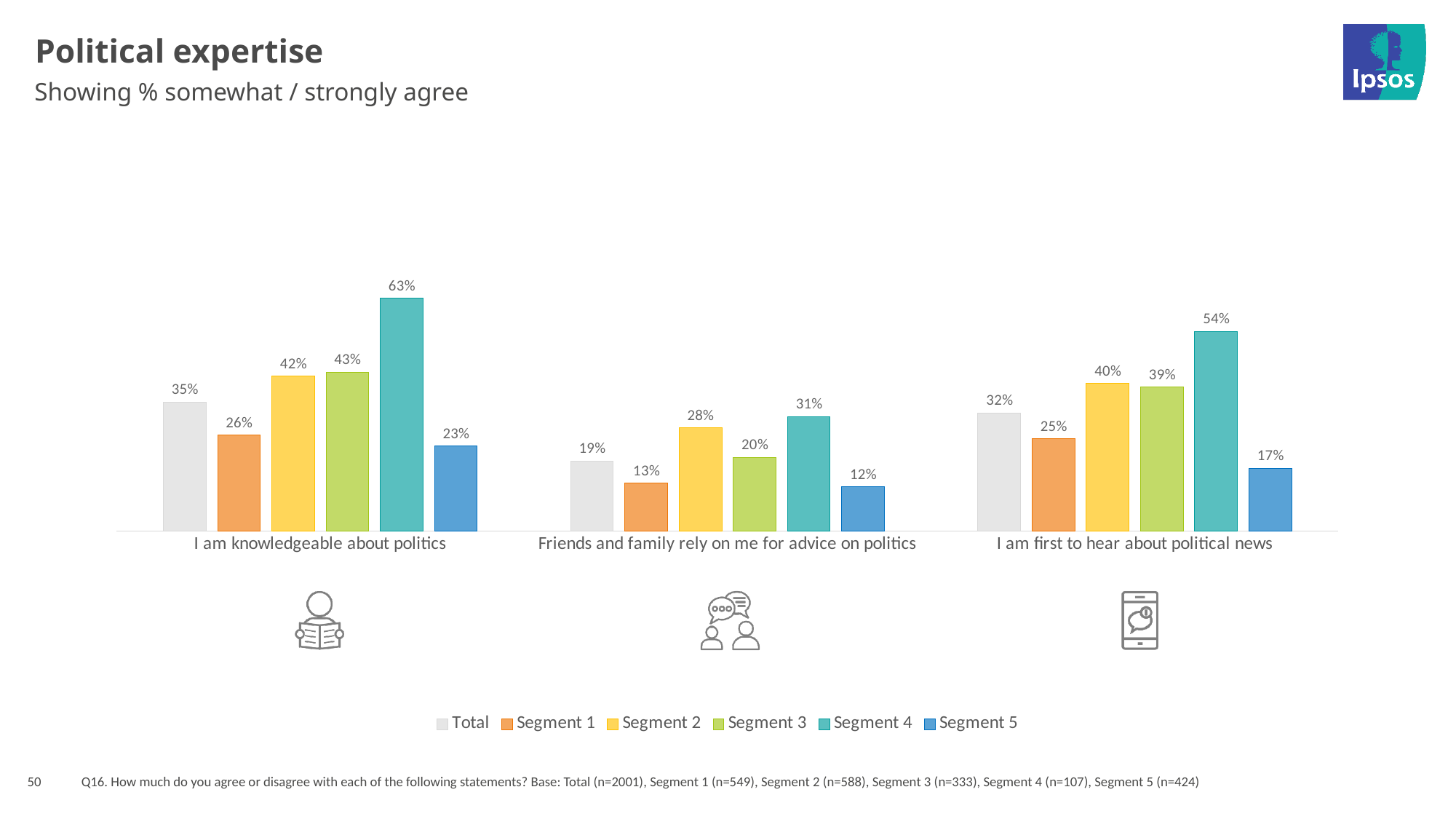
What is the title of the slide? Political expertise Which is larger for 'I am first to hear about political news': Segment 2 or Segment 3? Segment 2 What is the value for Segment 4 on 'I am knowledgeable about politics'? 63% What kind of chart is shown on the slide? Bar chart How many series does the legend list? 6 Which segment has the highest value for 'I am first to hear about political news'? Segment 4 Which segment has the lowest value for 'Friends and family rely on me for advice on politics'? Segment 5 What is the difference between Segment 2 and Segment 1 on 'Friends and family rely on me for advice on politics'? 15% What is the value for Segment 5 on 'I am first to hear about political news'? 17% How many statements (categories) are shown on the x axis? 3 What is the Total value for 'Friends and family rely on me for advice on politics'? 19% What is the difference between Segment 4 and Segment 5 on 'I am knowledgeable about politics'? 40%